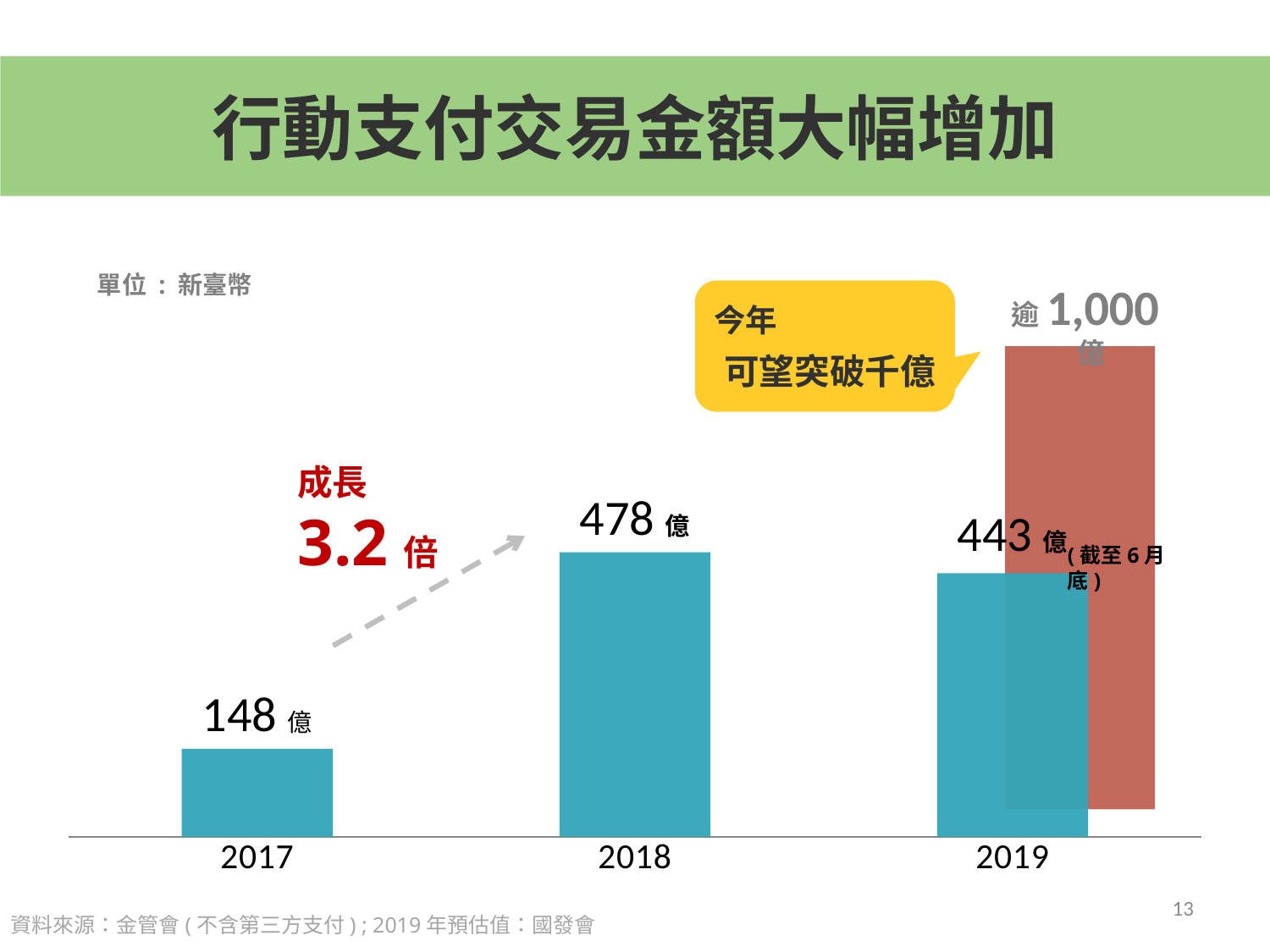
What value is labelled on the red bar for 2019? 逾 1,000 億 Which is larger, the 2018 value or the 2019 value as of end of June? 2018 What is the mobile payment transaction amount shown for 2018? 478 億 What is the difference between the 2018 value and the 2017 value? 330 億 What growth multiple is annotated between 2017 and 2018? 3.2 倍 What is the mobile payment transaction amount shown for 2017? 148 億 How many years are shown on the x axis? 3 What is the value labelled on the blue bar for 2019 (as of end of June)? 443 億 What kind of chart is shown on the slide? Bar chart Which year has the highest blue bar? 2018 What is the title of the slide? 行動支付交易金額大幅增加 Which year has the lowest blue bar? 2017